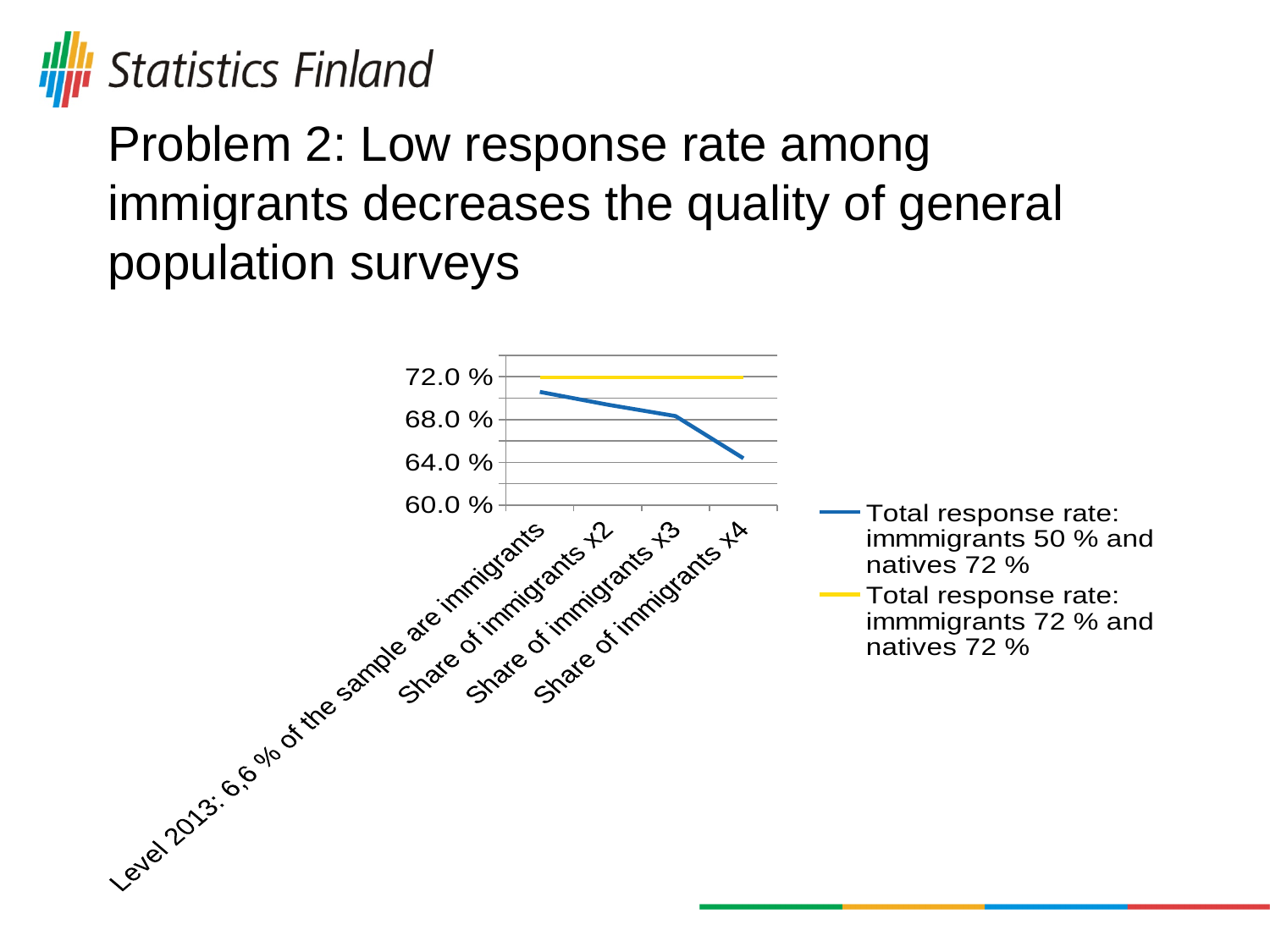
For the blue series, which category has the lowest value? Share of immigrants x4 Is the value of the blue series at 'Share of immigrants x4' greater or less than 68.0 %? less How many categories are shown along the x axis of the chart? 4 For the blue series, which category has the highest value? Level 2013: 6,6 % of the sample are immigrants Is the value of the blue series at 'Share of immigrants x2' greater or less than 72.0 %? less What colour is the line for the series 'Total response rate: immmigrants 72 % and natives 72 %'? yellow Does the blue series (immigrants 50 % and natives 72 %) rise or fall as the share of immigrants increases along the x axis? fall How many series does the chart's legend list? 2 At 'Share of immigrants x4', which series has the higher value, the blue or the yellow? yellow Is the value of the blue series at 'Level 2013: 6,6 % of the sample are immigrants' greater or less than 68.0 %? greater What kind of chart is shown on the slide? line chart